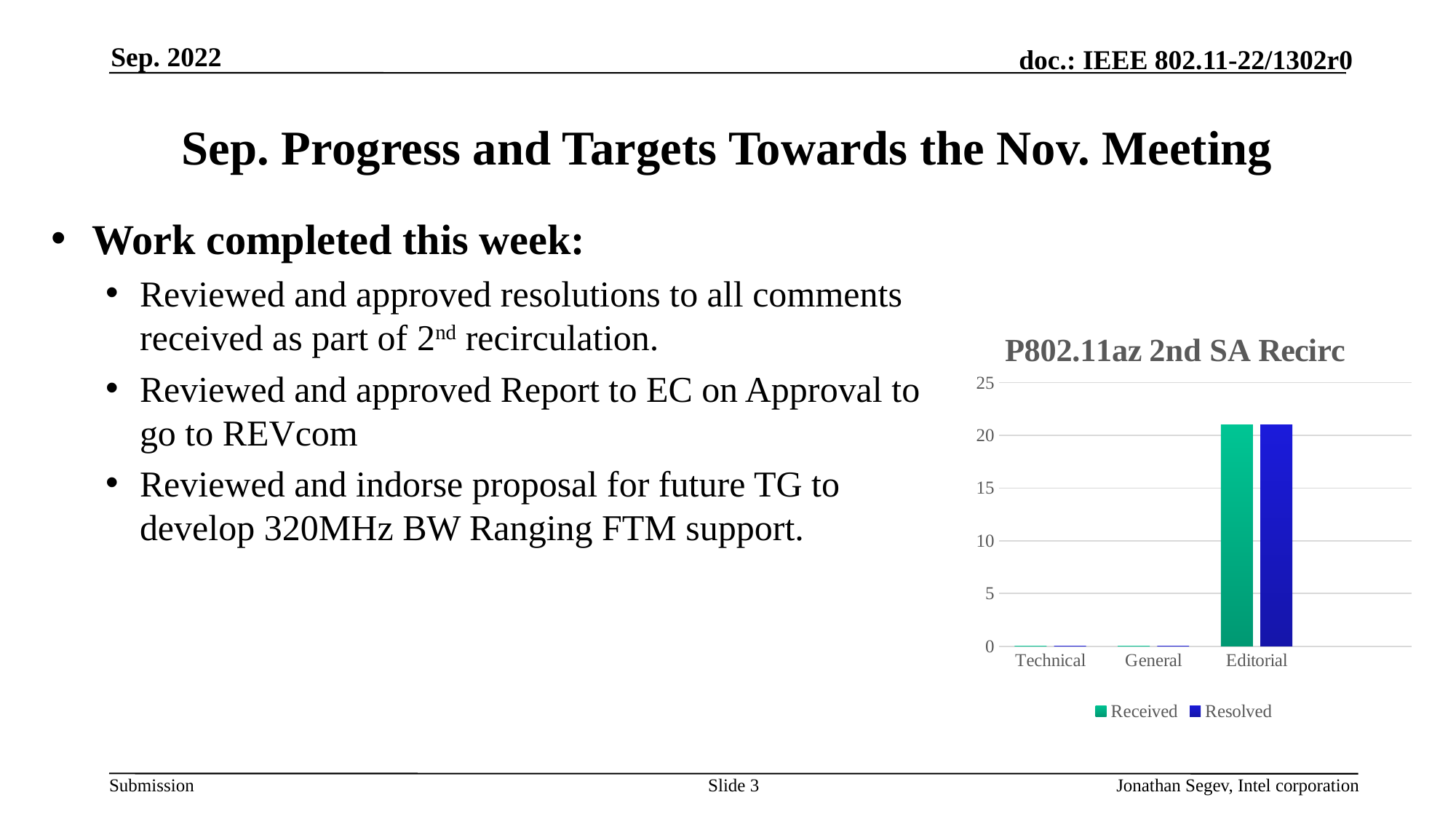
What is the title of the chart? P802.11az 2nd SA Recirc Which is larger, the Received value for Editorial or the Received value for General? Editorial Which category has the highest Resolved value? Editorial Which category has the highest Received value? Editorial Is the Resolved value for Editorial greater or less than 25? less How many categories are shown on the x axis of the chart? 3 What kind of chart is shown on the slide? bar chart Which is larger, the Resolved value for Editorial or the Resolved value for Technical? Editorial Is the Received value for Technical greater or less than 5? less Is the Received value for Editorial greater or less than 15? greater Which series is shown in blue in the chart? Resolved How many series does the chart legend list? 2